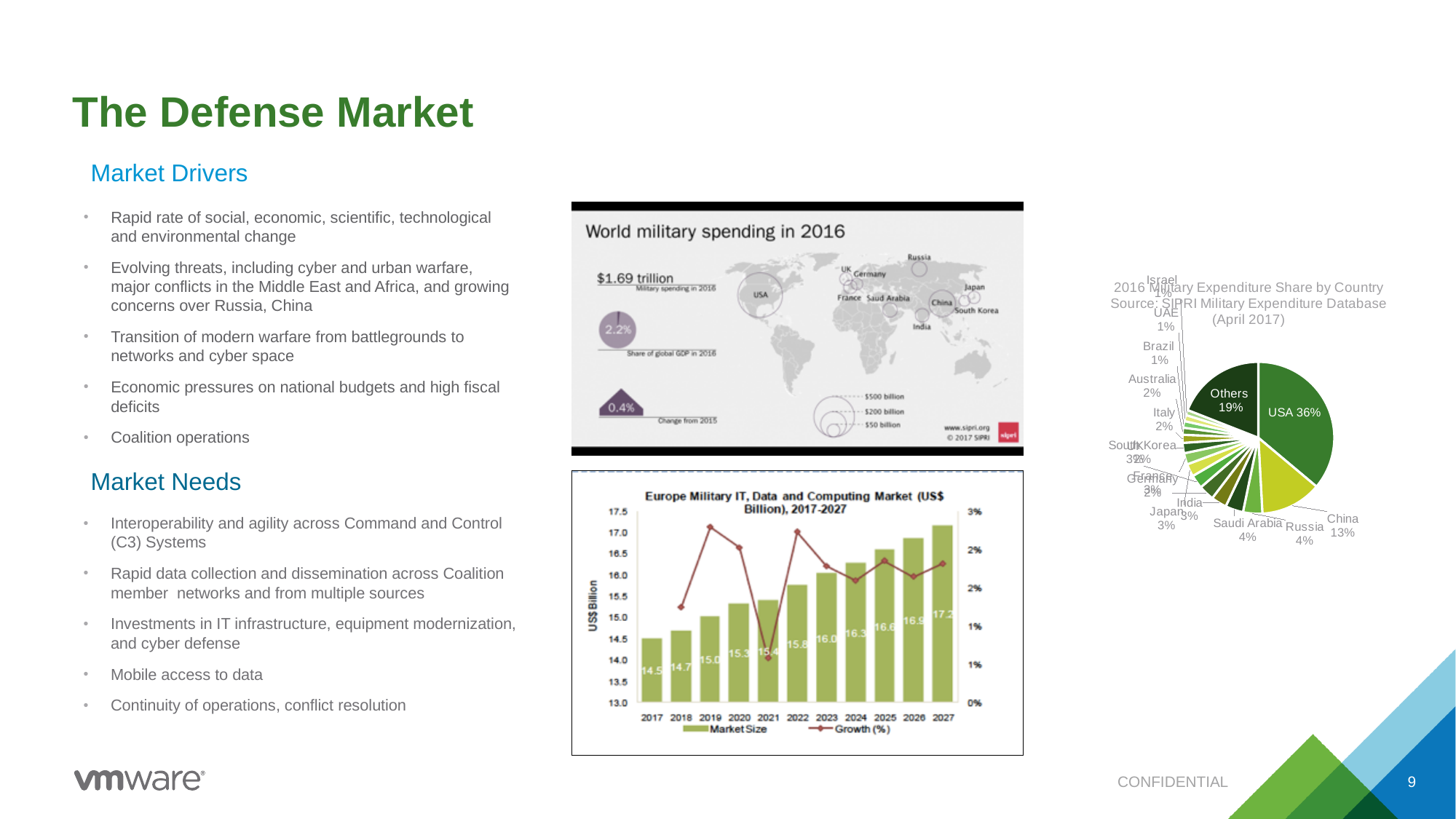
In the Europe Military IT, Data and Computing Market chart, what is the market size value for 2017? 14.5 In the 2016 Military Expenditure Share by Country pie chart, which is larger, China or Russia? China In the Europe Military IT, Data and Computing Market chart, which year has the lowest market size? 2017 In the Europe Military IT, Data and Computing Market chart, what is the market size value for 2027? 17.2 In the 2016 Military Expenditure Share by Country pie chart, what share does the USA have? 36% In the 2016 Military Expenditure Share by Country pie chart, what share does China have? 13% In the Europe Military IT, Data and Computing Market chart, how many series does the legend list? 2 In the Europe Military IT, Data and Computing Market chart, how many years are shown on the x axis? 11 In the 2016 Military Expenditure Share by Country pie chart, which country has the largest slice? USA In the Europe Military IT, Data and Computing Market chart, do the market size bars rise or fall from 2017 to 2027? rise In the Europe Military IT, Data and Computing Market chart, what is the difference between the market size in 2027 and in 2017? 2.7 In the World military spending in 2016 graphic, what is the total military spending shown? $1.69 trillion